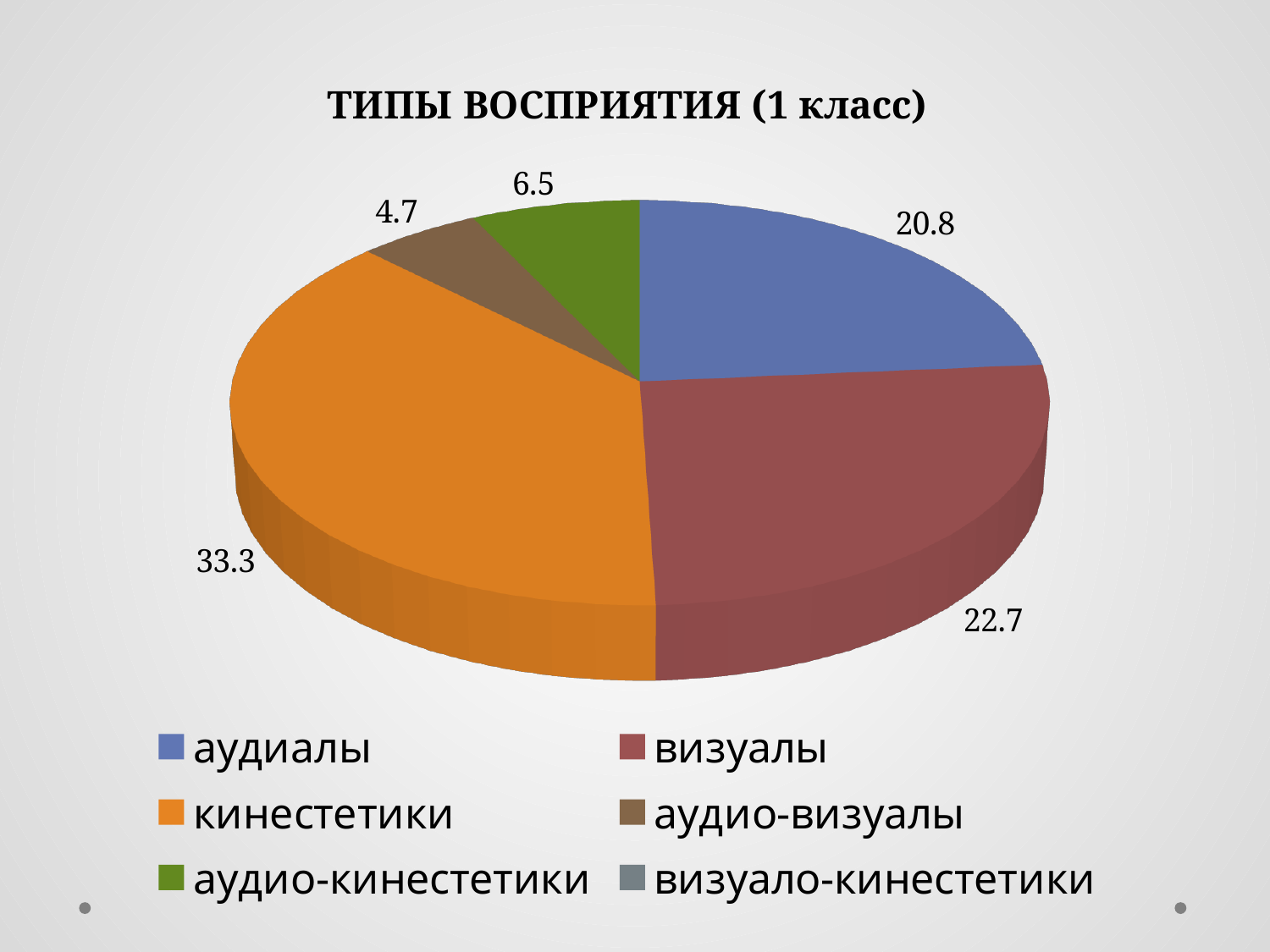
How many entries does the legend list? 6 What is the value for аудио-кинестетики? 6.5 What is the value for аудио-визуалы? 4.7 What is the difference between the values for кинестетики and визуалы? 10.6 Which labelled category has the smallest slice? аудио-визуалы Which category has the largest slice? кинестетики What is the title of the chart? ТИПЫ ВОСПРИЯТИЯ (1 класс) What is the value for аудиалы? 20.8 Which is larger, the value for визуалы or the value for аудиалы? визуалы What type of chart is shown on the slide? pie chart What is the value for кинестетики? 33.3 What is the value for визуалы? 22.7